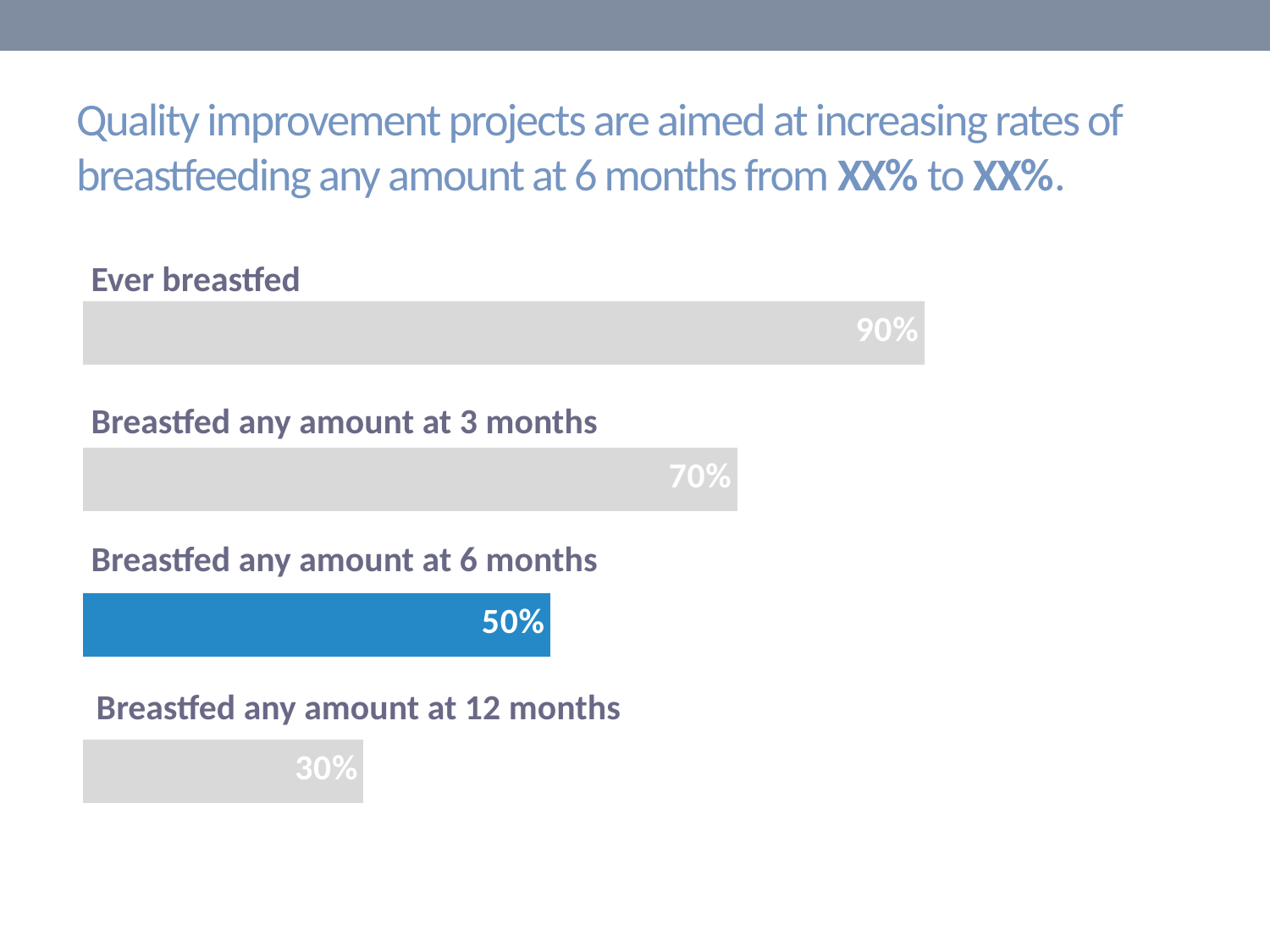
What is the difference between the value for Breastfed any amount at 3 months and the value for Breastfed any amount at 12 months? 40% What is the difference between the value for Ever breastfed and the value for Breastfed any amount at 6 months? 40% Which category has the highest value? Ever breastfed What is the value for Ever breastfed? 90% What is the value for Breastfed any amount at 12 months? 30% What kind of chart is shown on the slide? Bar chart What is the value for Breastfed any amount at 6 months? 50% Which bar is highlighted in blue rather than grey? Breastfed any amount at 6 months Which is larger, the value for Breastfed any amount at 3 months or the value for Breastfed any amount at 6 months? Breastfed any amount at 3 months Which category has the lowest value? Breastfed any amount at 12 months How many categories are shown in the chart? 4 What is the value for Breastfed any amount at 3 months? 70%